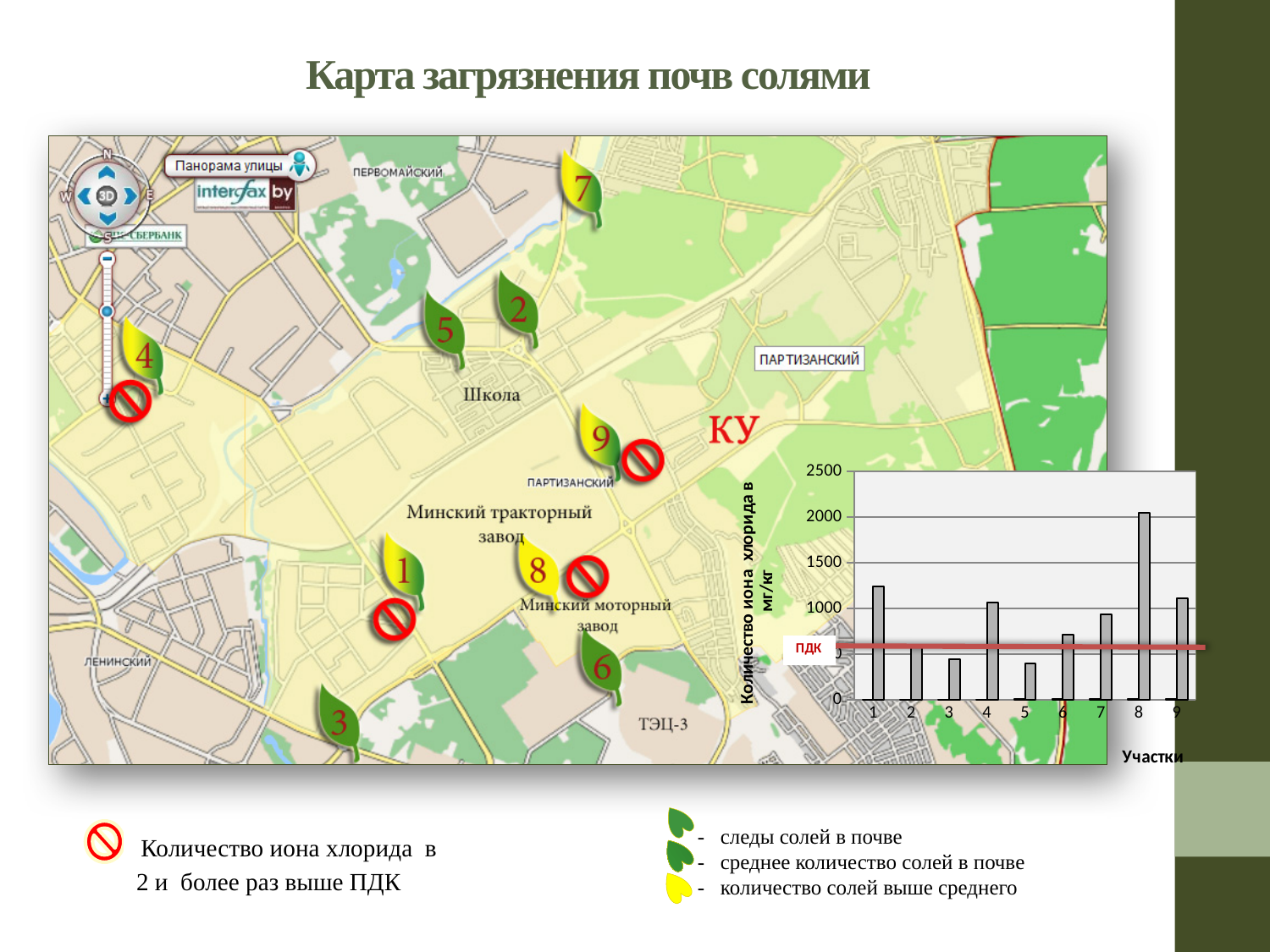
Which plot has the larger value, plot 8 or plot 1? 8 Is the value for plot 1 greater or less than 1000? greater What label is given to the red horizontal line on the bar chart? ПДК What is the label on the y axis of the bar chart? Количество иона хлорида в мг/кг What kind of chart is shown on the slide? bar chart Is the value for plot 5 greater or less than 500? less Which plot has the larger value, plot 4 or plot 3? 4 Which plot has the highest chloride ion value in the bar chart? 8 Is the value for plot 8 greater or less than 1500? greater How many plots (участки) are shown on the x axis of the bar chart? 9